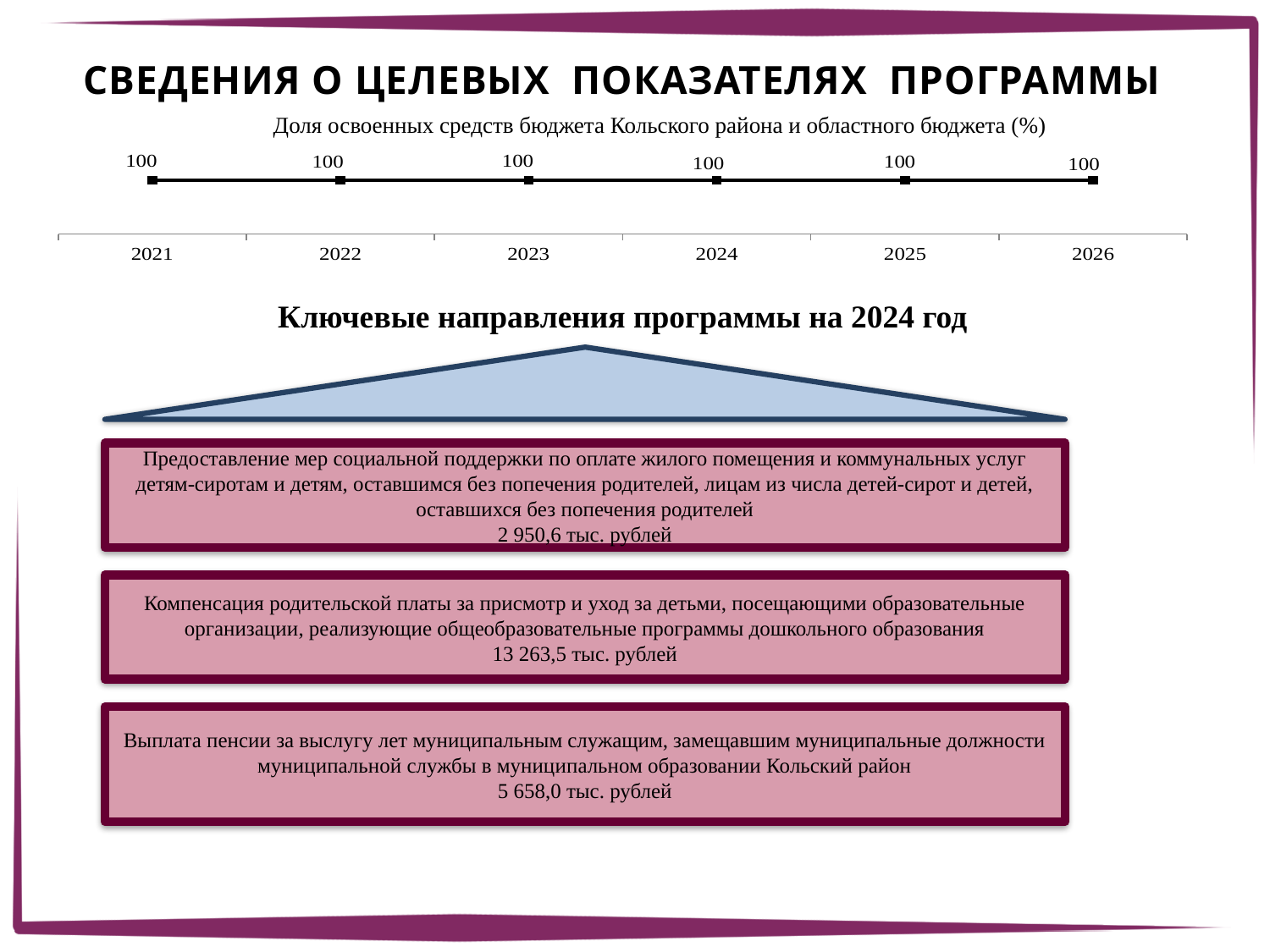
What type of chart is shown on the slide? line chart Is the value for 2025 larger than, smaller than or equal to the value for 2021 in the chart? equal What is the value for 2021 in the chart? 100 What is the value for 2024 in the chart? 100 What is the value for 2026 in the chart? 100 What is the difference between the values for 2024 and 2022 in the chart? 0 Do the values in the chart rise, fall or stay the same from 2021 to 2026? stay the same Which years are shown on the x axis of the chart? 2021, 2022, 2023, 2024, 2025, 2026 What is the title of the chart on the slide? Доля освоенных средств бюджета Кольского района и областного бюджета (%) How many data points are plotted in the chart? 6 What is the value for 2023 in the chart? 100